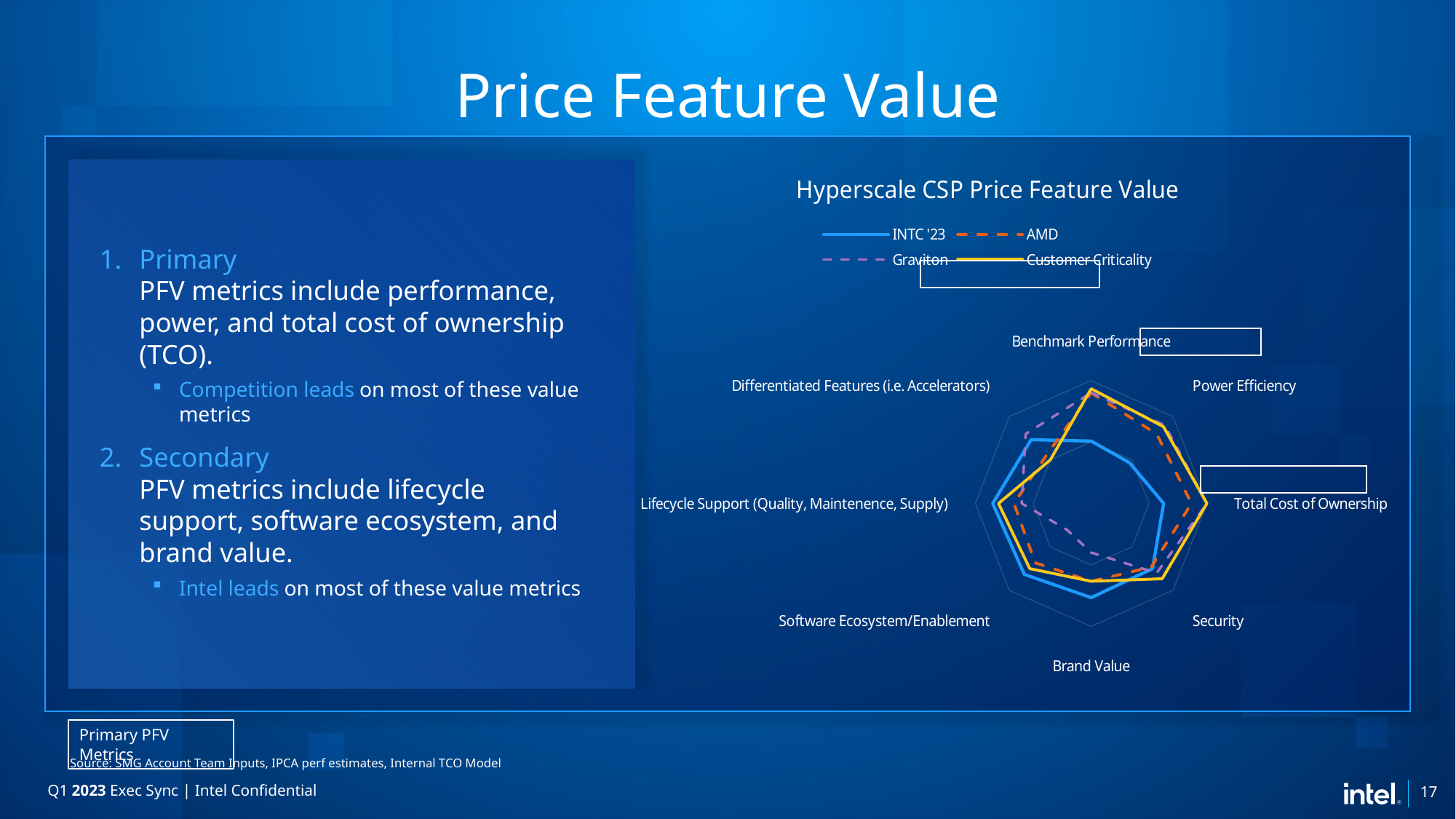
How many series does the chart legend list? 4 How many categories (axes) does the radar chart have? 8 On the Differentiated Features (i.e. Accelerators) axis, which series has the larger value, INTC '23 or Graviton? Graviton On the Total Cost of Ownership axis, which series has the larger value, INTC '23 or AMD? AMD What kind of chart is shown on the slide? Radar chart On the Benchmark Performance axis, which series has the larger value, INTC '23 or AMD? AMD Which series in the chart legend is drawn with a solid blue line? INTC '23 What is the title of the chart on the slide? Hyperscale CSP Price Feature Value